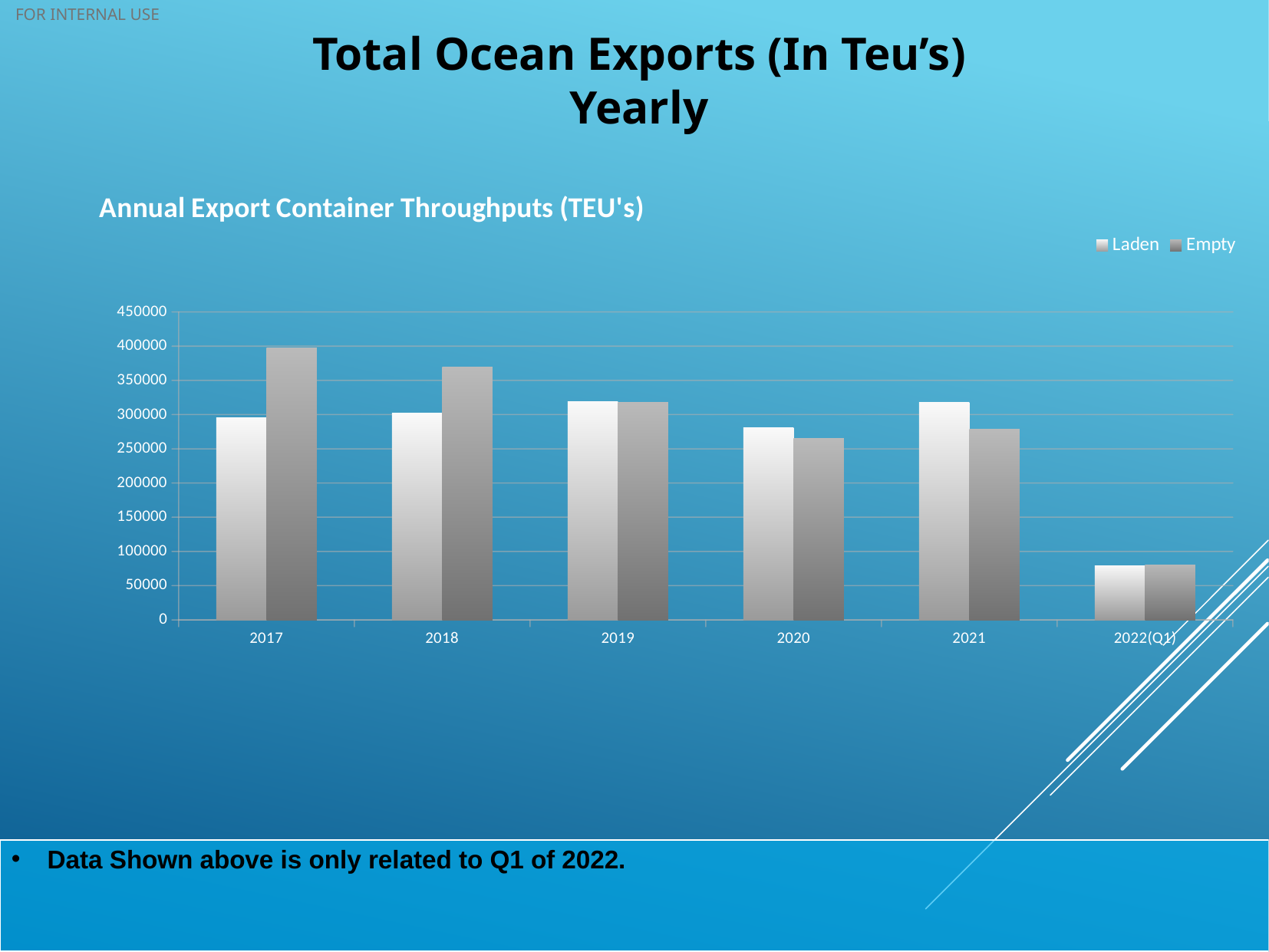
Which category has the lowest Laden value? 2022(Q1) Do the Empty values rise or fall from 2017 to 2020? fall What is the title of the chart? Annual Export Container Throughputs (TEU's) Is the Empty value for 2020 greater or less than 250000? greater In 2017, which is larger, Laden or Empty? Empty In 2021, which is larger, Laden or Empty? Laden Is the Laden value for 2022(Q1) greater or less than 100000? less What kind of chart is shown on the slide? bar chart Which year has the highest Empty value? 2017 Is the Empty value for 2017 greater or less than 350000? greater How many year categories are shown on the x axis? 6 How many series does the legend list? 2